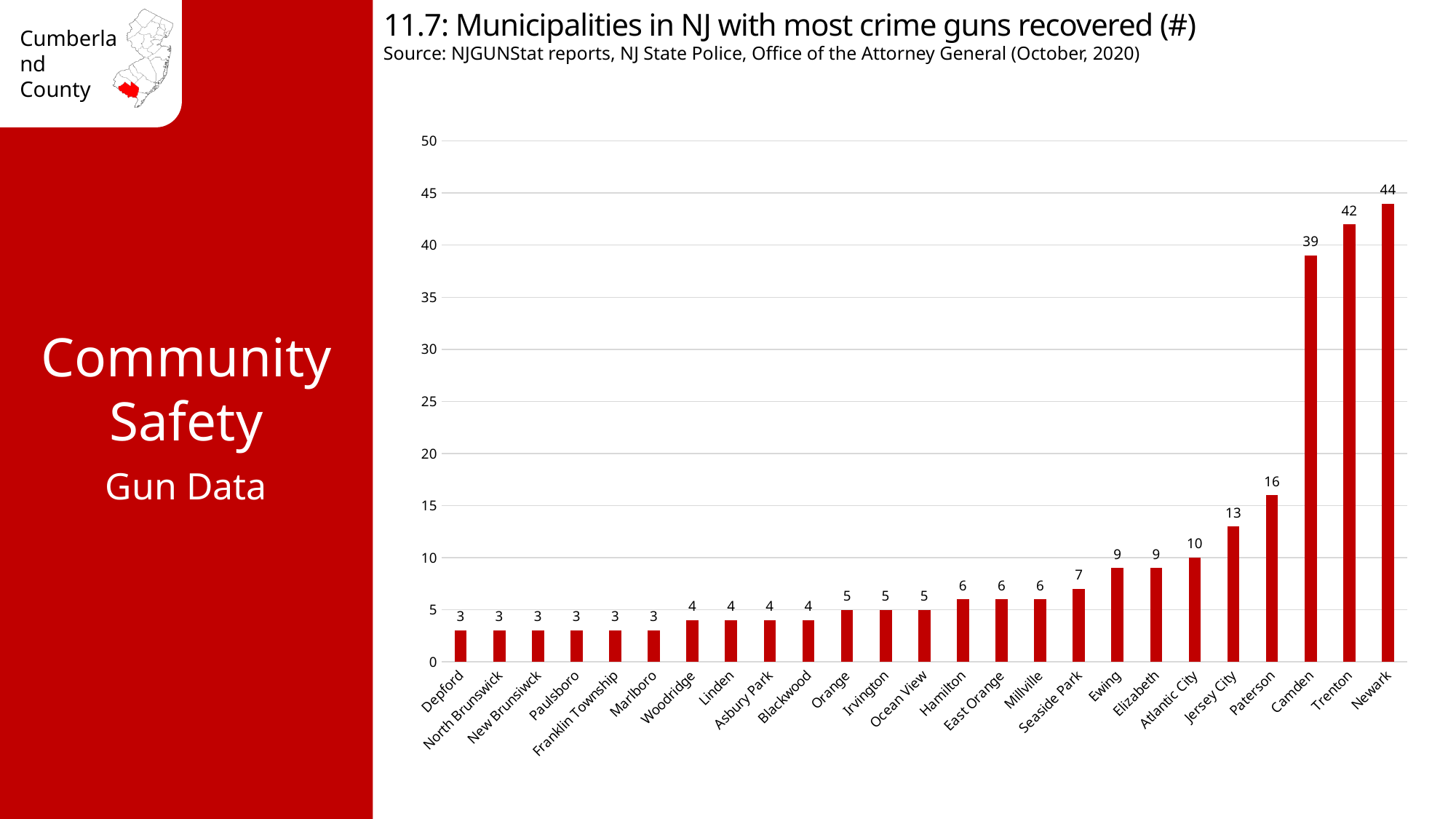
Which municipality has the highest number of crime guns recovered? Newark What is the value shown for Paterson? 16 What is the difference between the values for Jersey City and Atlantic City? 3 Do the values rise or fall moving from left to right along the x axis? Rise How many municipalities are shown on the chart? 25 Which has a larger value, Camden or Paterson? Camden What is the source cited for the chart? NJGUNStat reports, NJ State Police, Office of the Attorney General (October, 2020) What is the difference between the values for Newark and Trenton? 2 What kind of chart is shown on the slide? Bar chart How many crime guns were recovered in Camden? 39 What is the value shown for Millville? 6 Is the value for Trenton greater or less than 40? greater